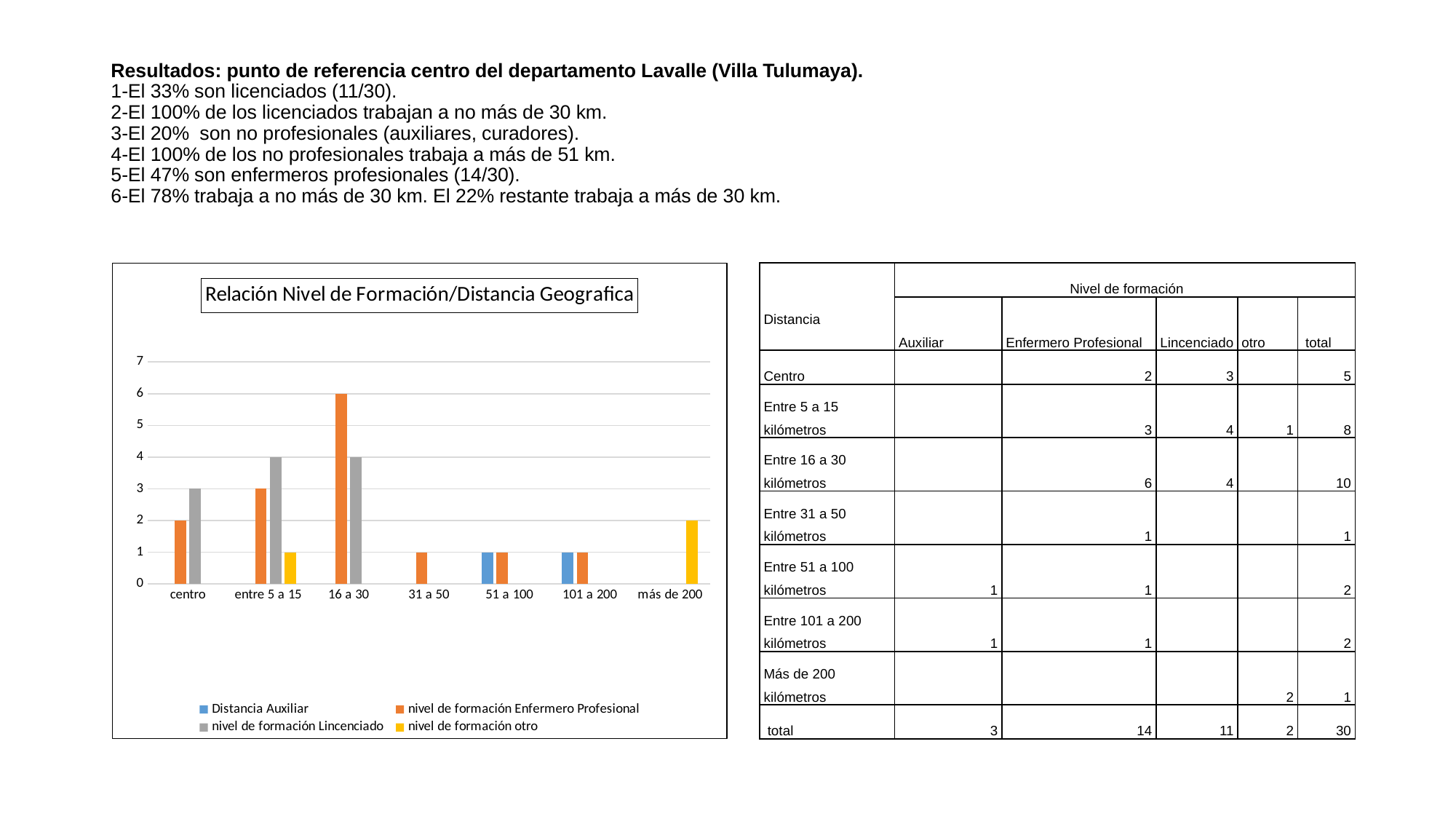
What is the title of the chart? Relación Nivel de Formación/Distancia Geografica What is the difference between the 'nivel de formación Enfermero Profesional' value for '16 a 30' and for 'entre 5 a 15'? 3 What type of chart is shown on the slide? bar chart What is the value of the 'nivel de formación otro' series for the 'más de 200' category? 2 What is the value of the 'nivel de formación Enfermero Profesional' series for the '16 a 30' category? 6 For the 'entre 5 a 15' category, which is larger: the 'nivel de formación Lincenciado' value or the 'nivel de formación Enfermero Profesional' value? nivel de formación Lincenciado Is the 'nivel de formación Enfermero Profesional' value for '16 a 30' greater or less than 5? greater What is the value of the 'Distancia Auxiliar' series for the '51 a 100' category? 1 Which category has the highest value for the 'nivel de formación Enfermero Profesional' series? 16 a 30 How many distance categories are shown on the x axis of the chart? 7 What is the value of the 'nivel de formación Lincenciado' series for the 'centro' category? 3 How many series does the chart legend list? 4